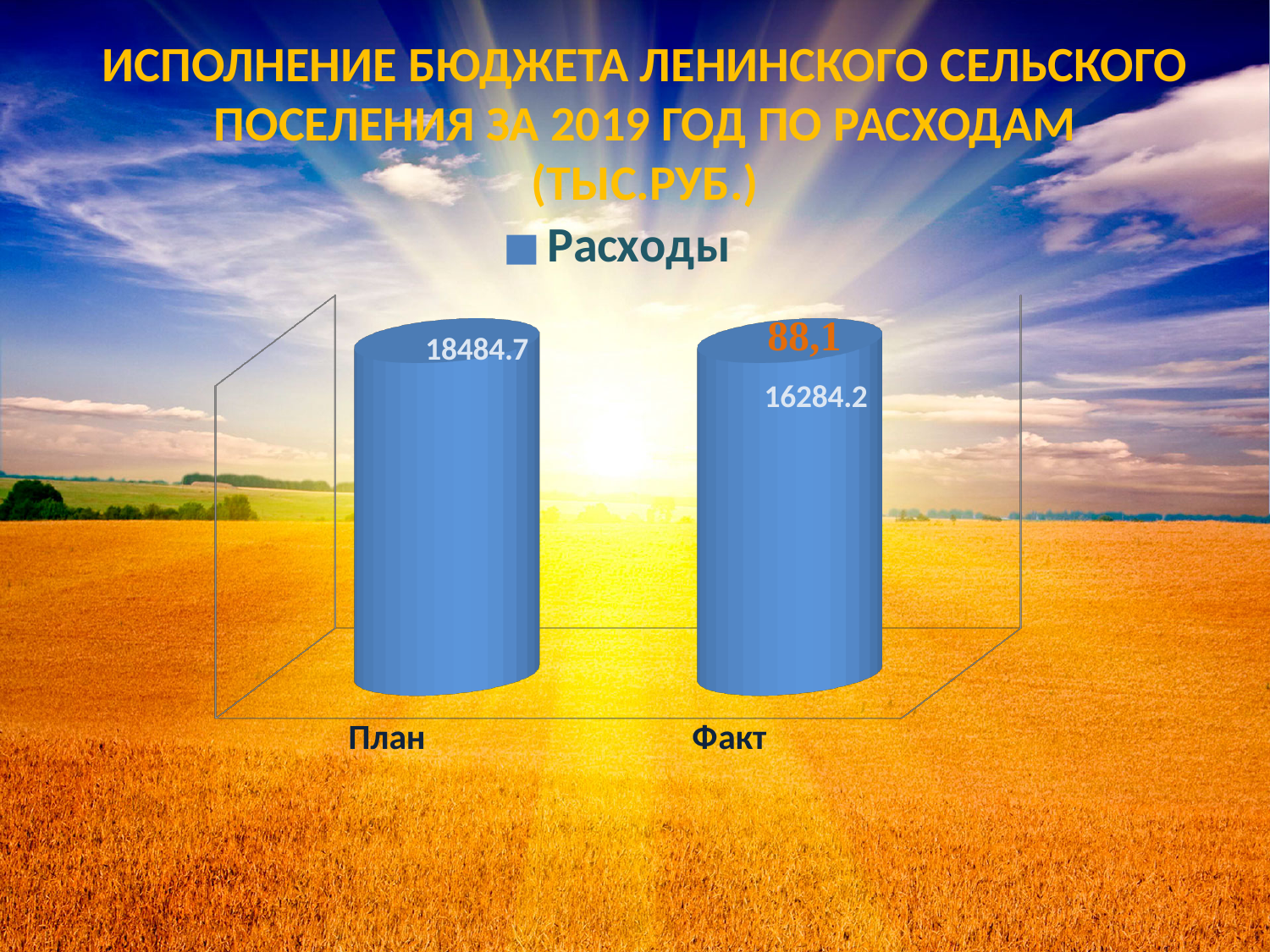
How many series does the legend list? 1 Do the values rise or fall from План to Факт? Fall Which is larger, the value for План or the value for Факт? План What is the difference between the values for План and Факт? 2200.5 Which category has the lowest value? Факт What orange number is printed above the Факт bar? 88,1 Which category has the highest value? План How many categories are shown on the chart? 2 What is the value for Факт? 16284.2 What kind of chart is shown on the slide? Bar chart What series name is shown in the chart legend? Расходы What is the value for План? 18484.7